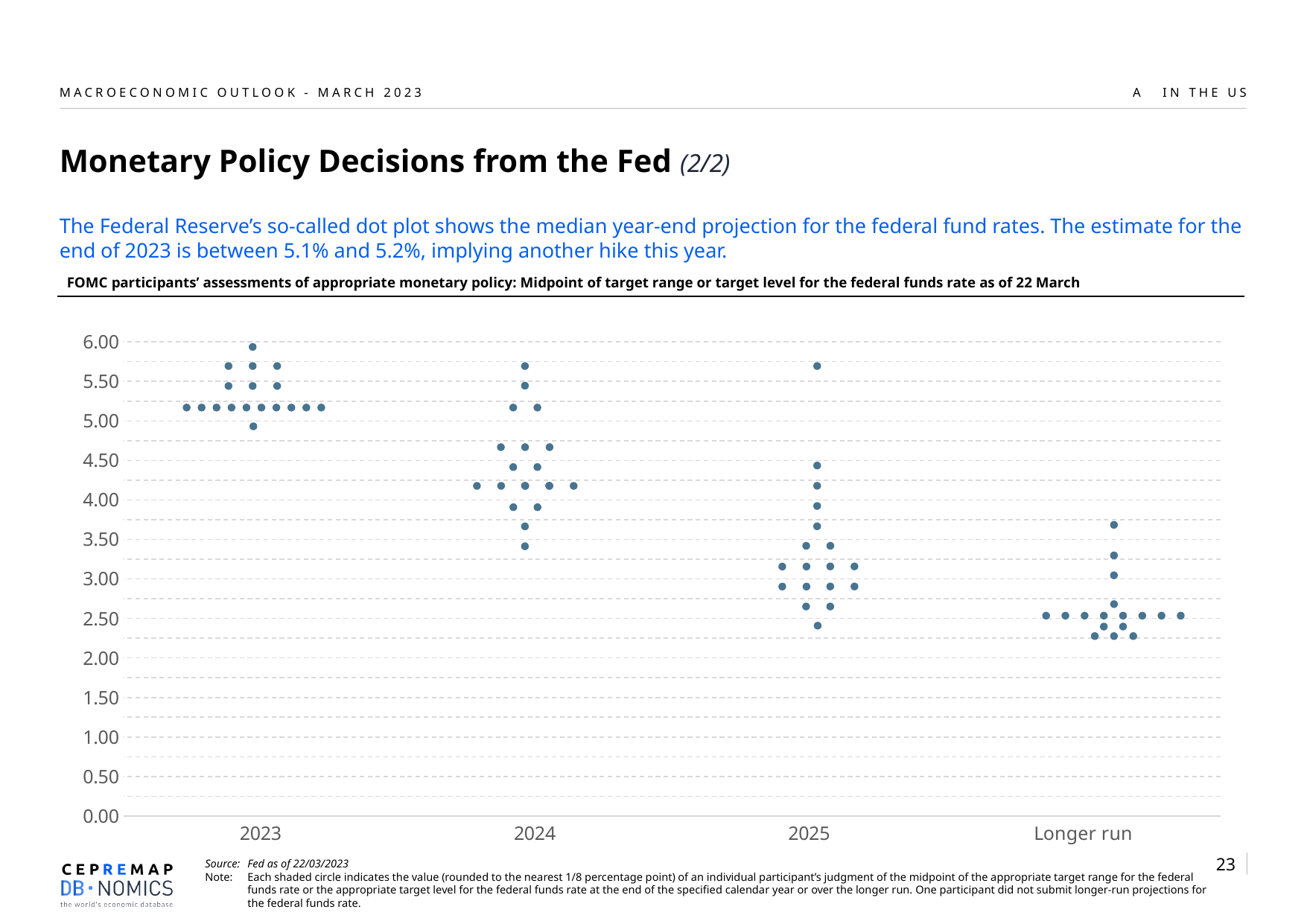
Is the highest dot for Longer run greater or less than 3.50? greater According to the chart title, as of what date are the FOMC participants' assessments shown? 22 March How many categories are shown on the x axis of the chart? 4 Is the highest dot for 2025 greater or less than 5.00? greater What kind of chart is shown on the slide? Dot plot (scatter chart) Is the lowest dot for 2024 greater or less than 4.00? less Do the dots generally rise or fall moving from 2023 to Longer run along the x axis? fall Which has the higher top dot, 2023 or 2024? 2023 Which category on the x axis contains the highest dot in the chart? 2023 Which category on the x axis contains the lowest dot in the chart? Longer run